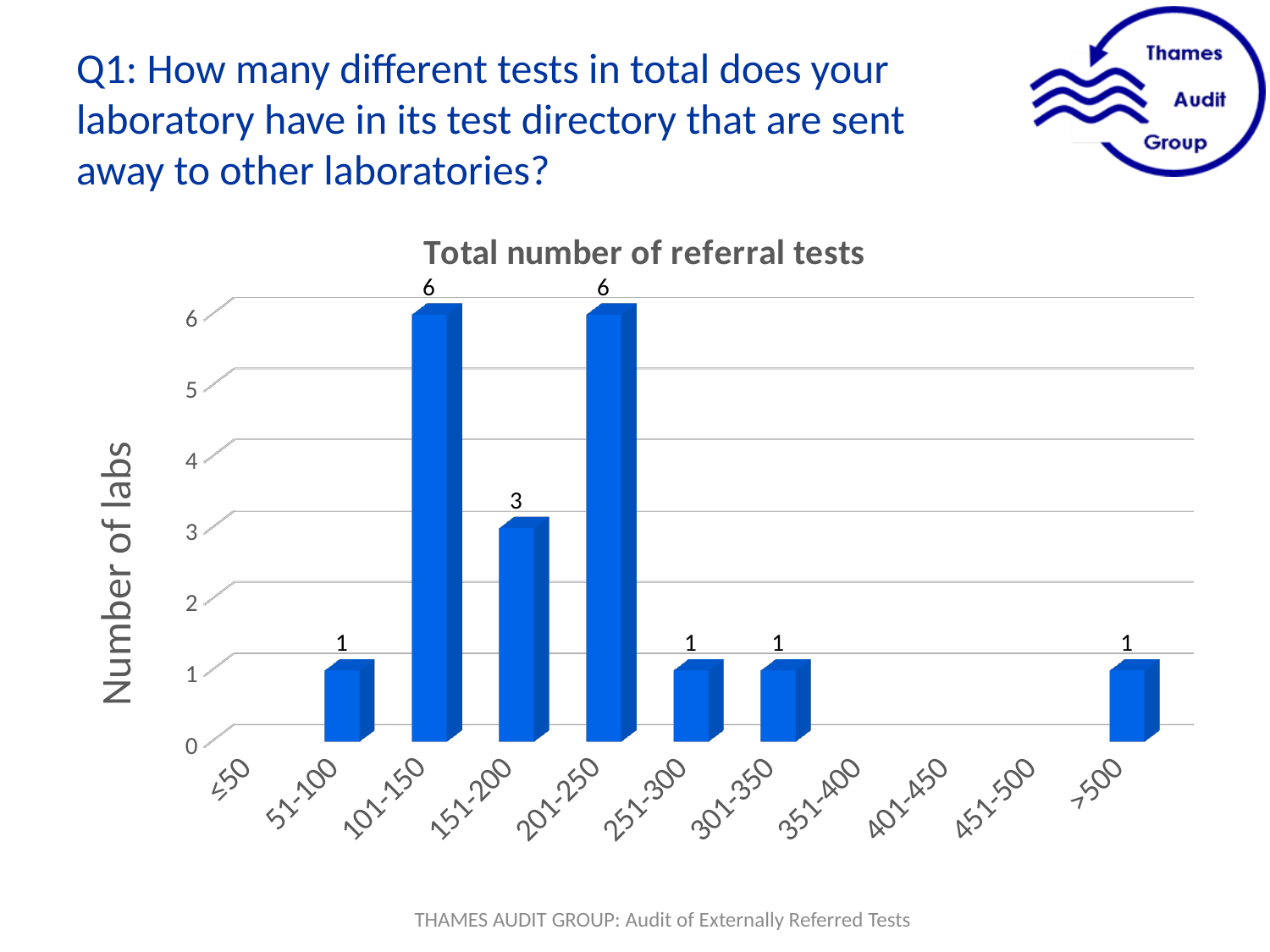
What is the difference between the values for 201-250 and 301-350? 5 What is the number of labs for the 151-200 category? 3 How many labs reported more than 500 referral tests (the >500 category)? 1 How many labs are in the 101-150 category? 6 What is the highest number of labs shown for any category? 6 How many categories are shown on the x axis of the chart? 11 Which category has more labs, 151-200 or 251-300? 151-200 What is the difference between the number of labs in the 101-150 category and the 151-200 category? 3 What is the value for the 51-100 category? 1 What type of chart is shown on the slide? Bar chart Is the value for the 201-250 category greater or less than 5? greater What is the label of the vertical axis of the chart? Number of labs